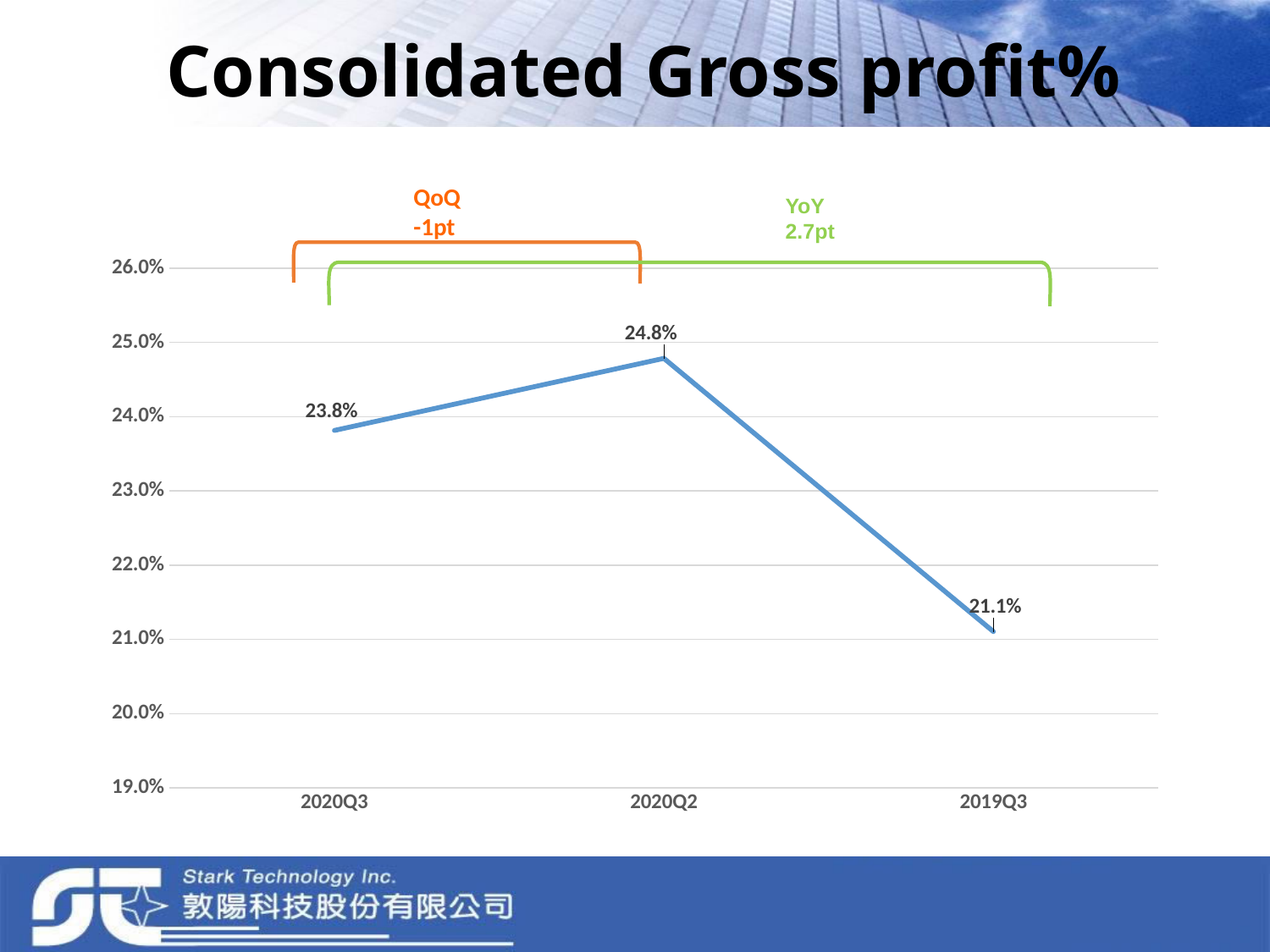
What is the consolidated gross profit % for 2020Q3? 23.8% What kind of chart is shown on the slide? line chart What is the difference in gross profit % between 2020Q3 and 2019Q3? 2.7% Which is larger, the gross profit % for 2020Q3 or for 2019Q3? 2020Q3 What is the consolidated gross profit % for 2020Q2? 24.8% What is the difference in gross profit % between 2020Q2 and 2020Q3? 1.0% How many periods are plotted on the chart? 3 What YoY change is annotated on the chart? 2.7pt Which period has the lowest gross profit %? 2019Q3 What is the consolidated gross profit % for 2019Q3? 21.1% Is the value for 2019Q3 greater or less than 22.0%? less Which period has the highest gross profit %? 2020Q2